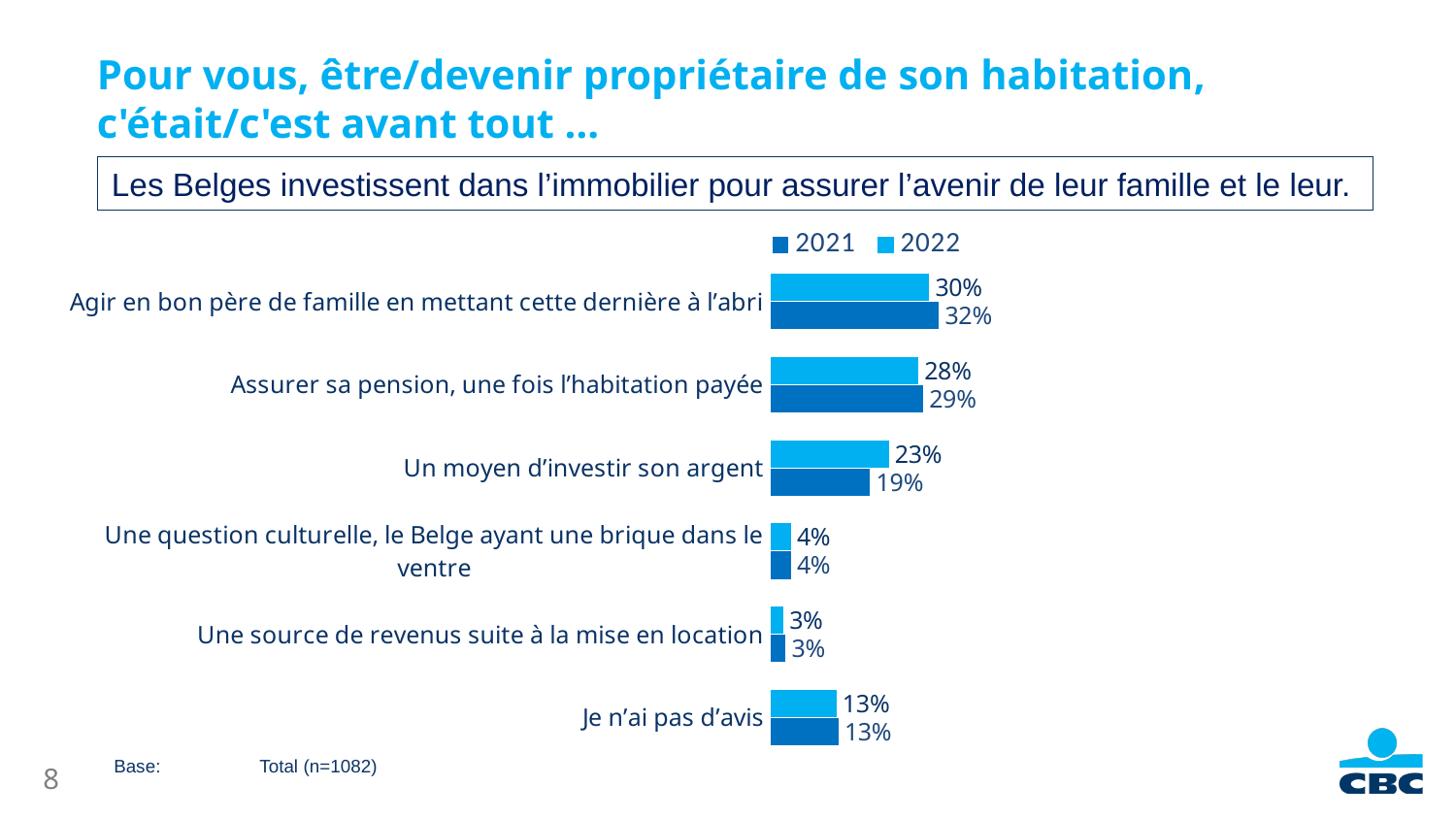
What is the 2021 value for "Un moyen d'investir son argent"? 19% How many categories are shown in the chart? 6 What is the 2021 value for "Agir en bon père de famille en mettant cette dernière à l'abri"? 32% What is the 2022 value for "Je n'ai pas d'avis"? 13% What is the difference between the 2022 and 2021 values for "Un moyen d'investir son argent"? 4% Which series is shown in the lighter blue colour? 2022 How many series does the legend list? 2 For "Agir en bon père de famille en mettant cette dernière à l'abri", which year has the larger value, 2021 or 2022? 2021 Which category has the highest 2022 value? Agir en bon père de famille en mettant cette dernière à l'abri Which category has the lowest 2021 value? Une source de revenus suite à la mise en location What kind of chart is shown on the slide? Bar chart What is the 2022 value for "Assurer sa pension, une fois l'habitation payée"? 28%